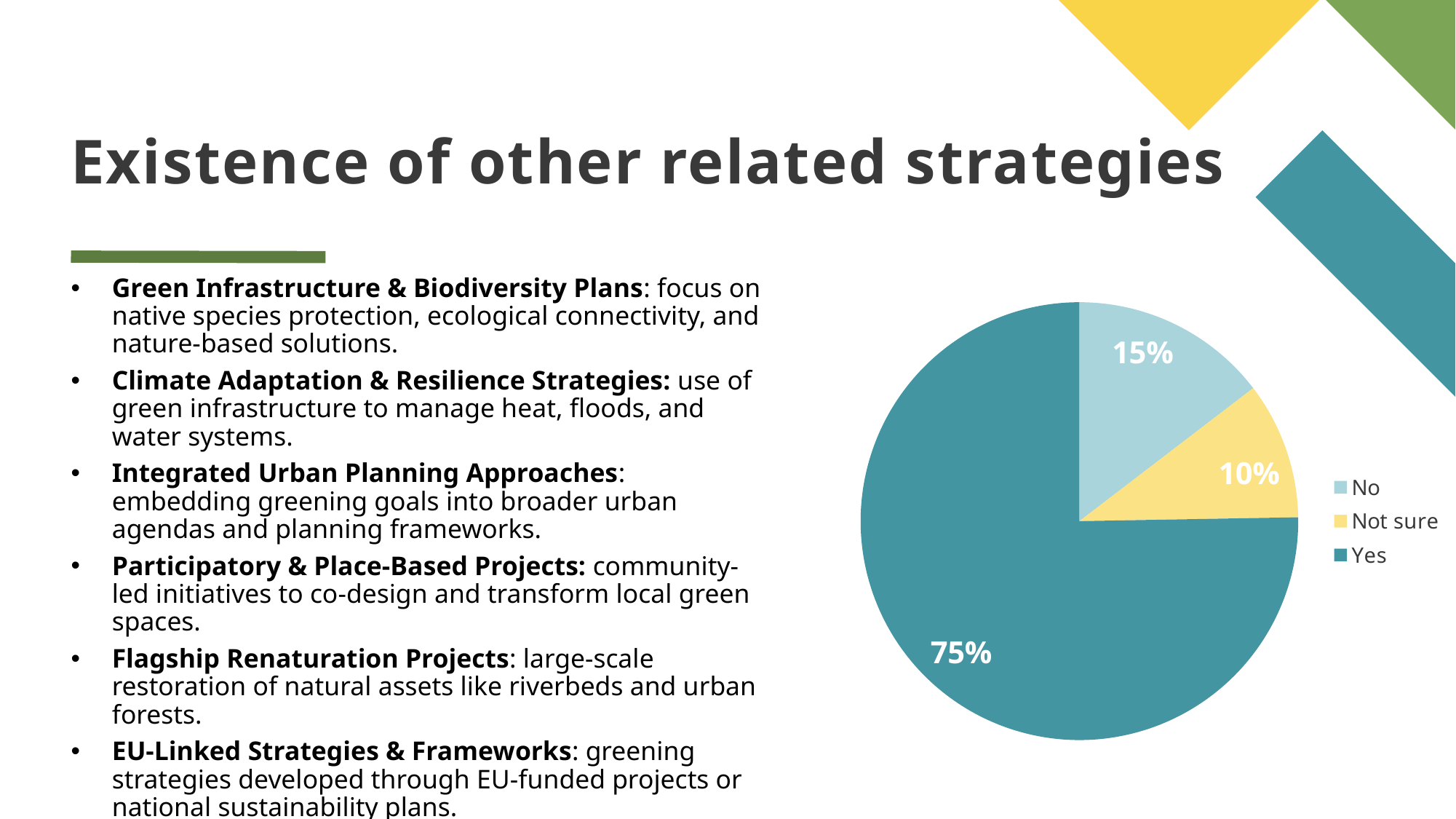
What kind of chart is shown on the slide? pie chart Which is larger, the "No" slice or the "Not sure" slice? No How many entries does the legend list? 3 What share of the pie does "Not sure" represent? 10% What colour is the "Not sure" slice? yellow Which category has the largest slice of the pie? Yes What share of the pie does "No" represent? 15% Which category has the smallest slice of the pie? Not sure How many categories does the pie chart have? 3 What is the difference in percentage points between the "No" and "Not sure" slices? 5 What is the difference in percentage points between the "Yes" and "No" slices? 60 What share of the pie does "Yes" represent? 75%